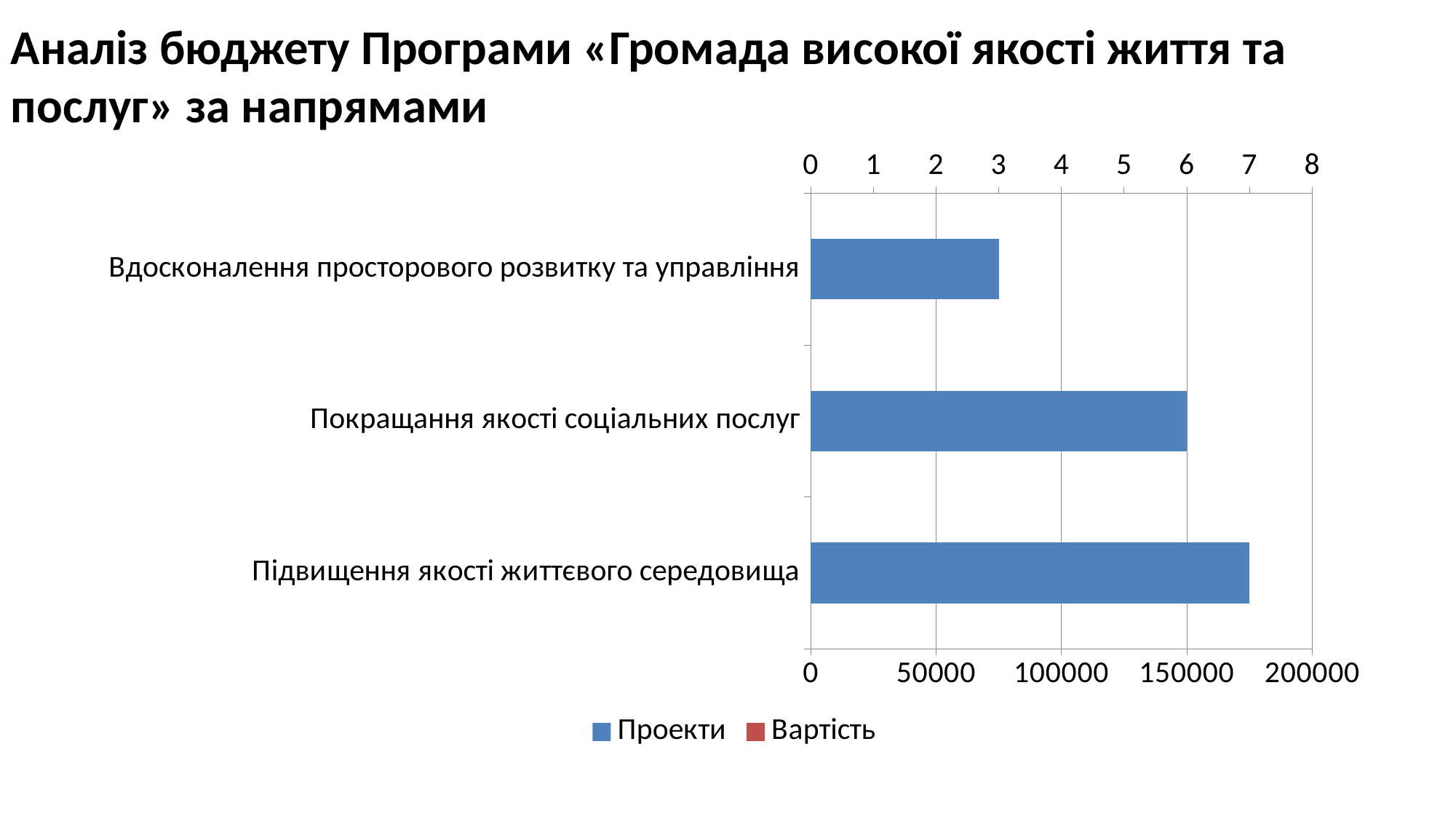
Which bar is longer: Покращання якості соціальних послуг or Вдосконалення просторового розвитку та управління? Покращання якості соціальних послуг Which category has the longest bar? Підвищення якості життєвого середовища On the bottom axis, is the bar for Підвищення якості життєвого середовища greater or less than 150000? greater What are the two series named in the legend? Проекти and Вартість Which category has the shortest bar? Вдосконалення просторового розвитку та управління How many categories are shown on the chart? 3 On the bottom axis, is the bar for Вдосконалення просторового розвитку та управління greater or less than 100000? less What kind of chart is shown on the slide? bar chart Which bar is longer: Підвищення якості життєвого середовища or Покращання якості соціальних послуг? Підвищення якості життєвого середовища On the top axis, is the bar for Вдосконалення просторового розвитку та управління greater or less than 4? less How many series does the legend list? 2 What is the maximum value shown on the bottom axis? 200000